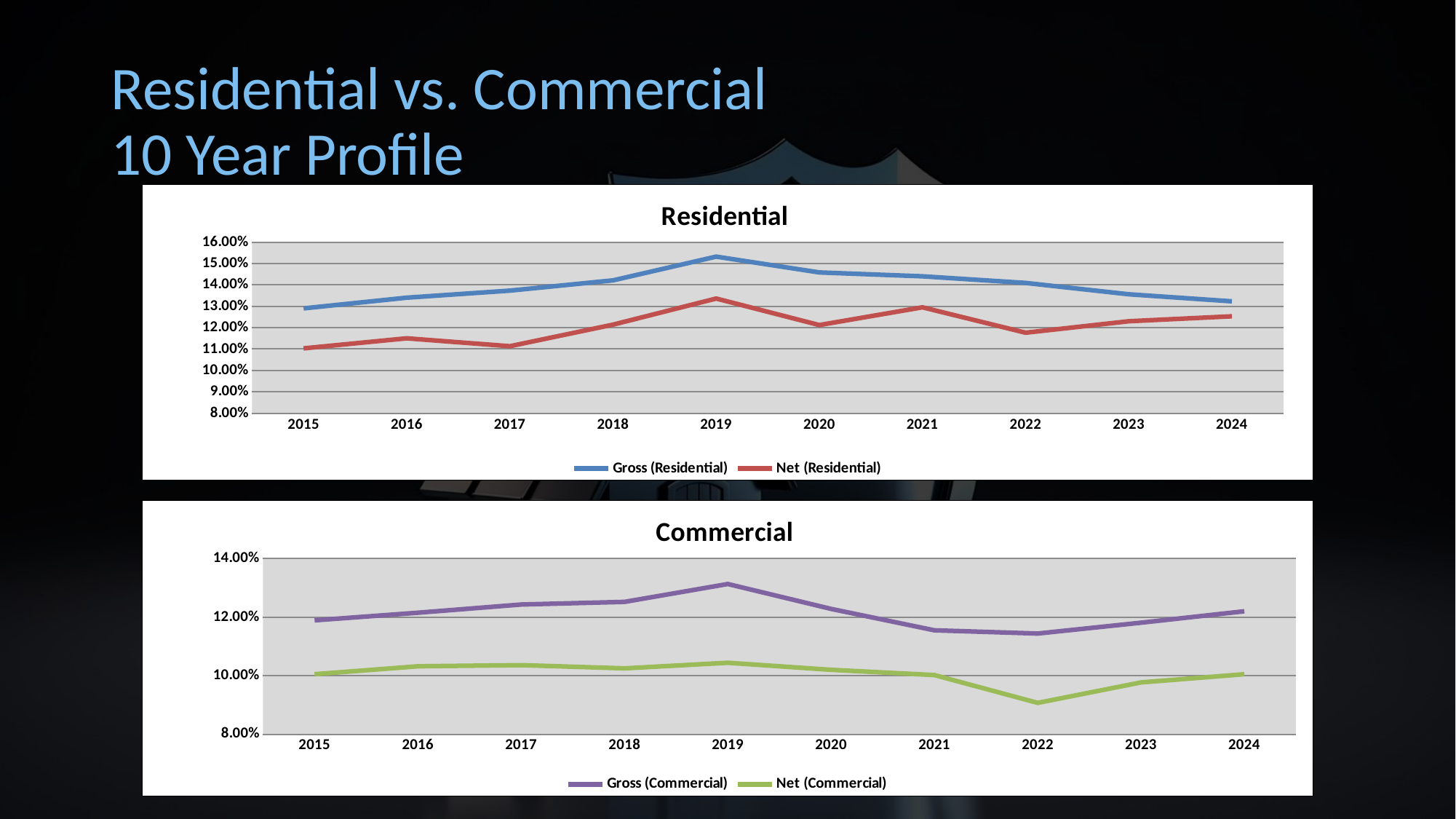
In the Commercial chart, is the Net (Commercial) value for 2022 greater or less than 10.00%? less In the Residential chart, is the Net (Residential) value for 2022 greater or less than 12.00%? less In the Residential chart, which year has the highest Gross (Residential) value? 2019 In the Residential chart, which year has the lowest Gross (Residential) value? 2015 What kind of chart is the Residential chart? line chart What colour is the Net (Commercial) line in the Commercial chart? green How many years are plotted on the x axis of the Residential chart? 10 In the Commercial chart, which year has the highest Gross (Commercial) value? 2019 In the Commercial chart, which is larger in 2024, Gross (Commercial) or Net (Commercial)? Gross (Commercial) In the Commercial chart, which year has the lowest Net (Commercial) value? 2022 In the Residential chart, is the Gross (Residential) value for 2019 greater or less than 15.00%? greater How many series does the legend of the Commercial chart list? 2